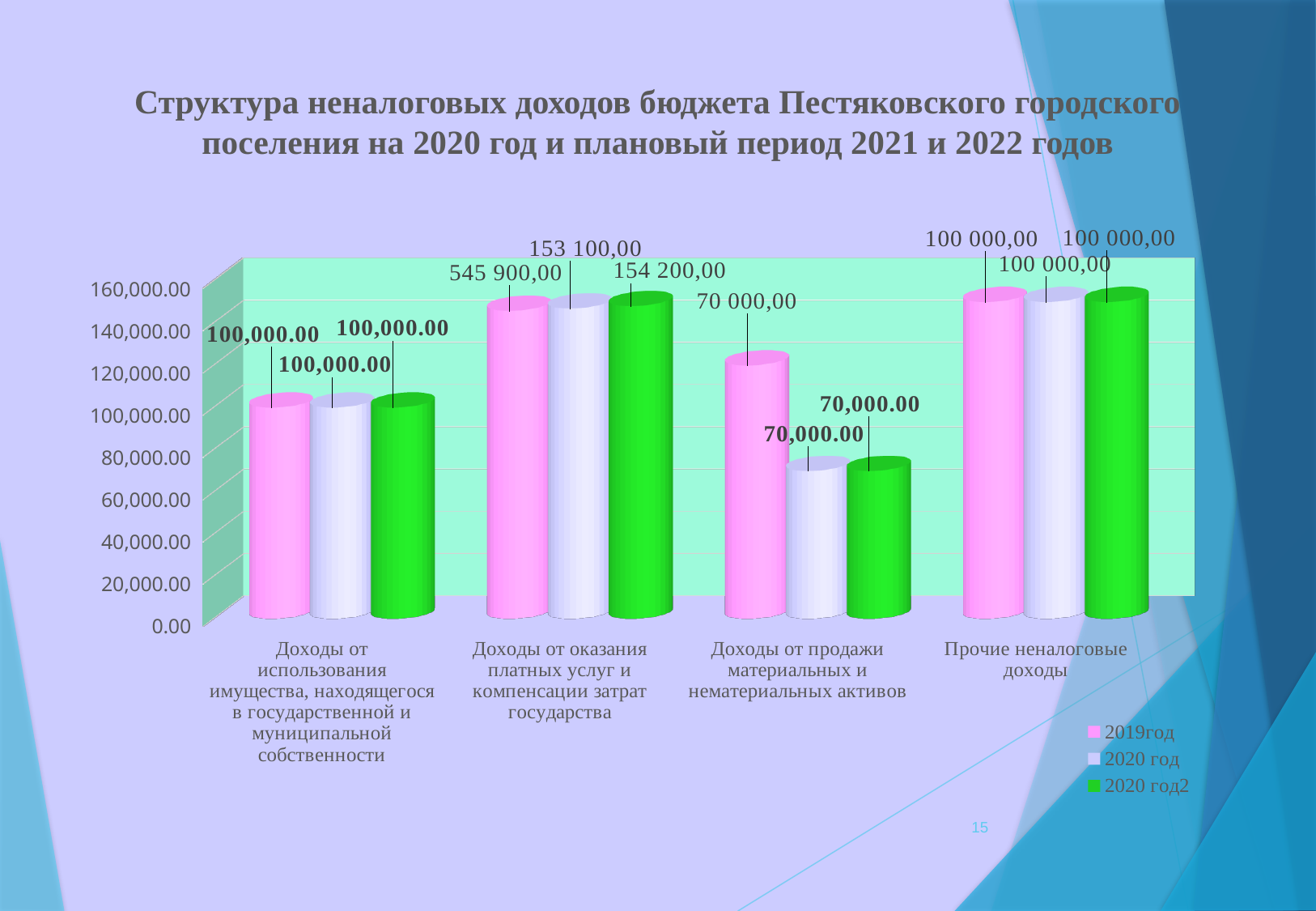
What kind of chart is shown on the slide? bar chart How many series does the chart legend list? 3 What is the value for 2020 год2 in the category 'Прочие неналоговые доходы'? 100 000,00 What is the value for 2019год in the category 'Доходы от продажи материальных и нематериальных активов'? 70 000,00 Is the 2020 год2 value for 'Доходы от продажи материальных и нематериальных активов' greater or less than 100,000.00? less Which series is shown in green in the chart legend? 2020 год2 Which category has the lowest value for the 2020 год series? Доходы от продажи материальных и нематериальных активов What is the value for 2019год in the category 'Доходы от использования имущества, находящегося в государственной и муниципальной собственности'? 100,000.00 How many categories are shown on the x axis of the chart? 4 What is the difference between the 2020 год2 and 2020 год values in the category 'Доходы от оказания платных услуг и компенсации затрат государства'? 1 100,00 What is the value for 2020 год in the category 'Доходы от оказания платных услуг и компенсации затрат государства'? 153 100,00 What is the value for 2020 год2 in the category 'Доходы от оказания платных услуг и компенсации затрат государства'? 154 200,00